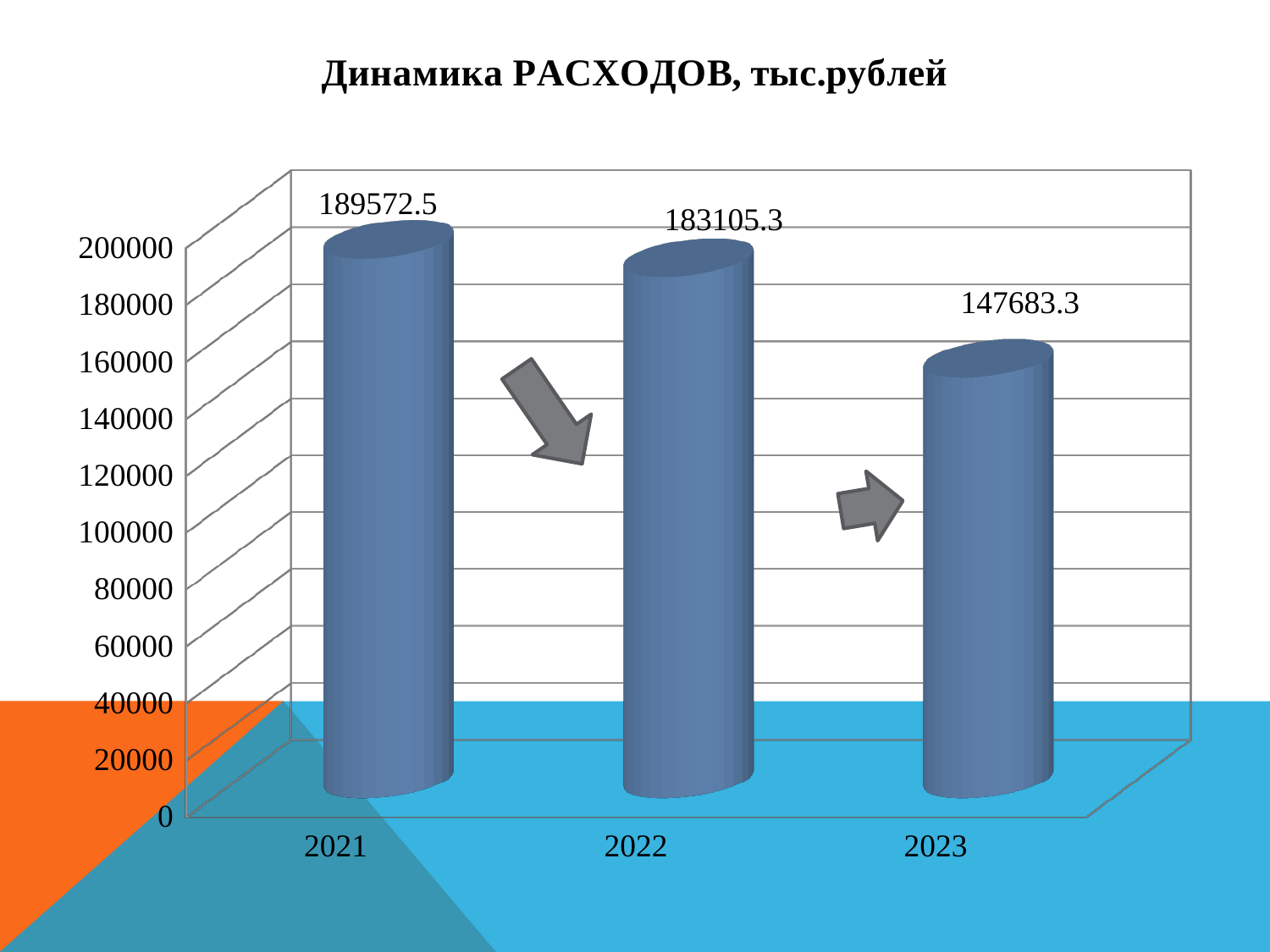
Which is larger, the value for 2021 or the value for 2022? 2021 Which year has the lowest value? 2023 What is the value for 2022? 183105.3 Do the values rise or fall from 2021 to 2023? fall Is the value for 2023 greater or less than 160000? less What is the value for 2021? 189572.5 What is the difference between the values for 2021 and 2023? 41889.2 What is the value for 2023? 147683.3 How many years are shown on the x axis? 3 What is the difference between the values for 2022 and 2023? 35422 What kind of chart is shown on the slide? bar chart Which year has the highest value? 2021